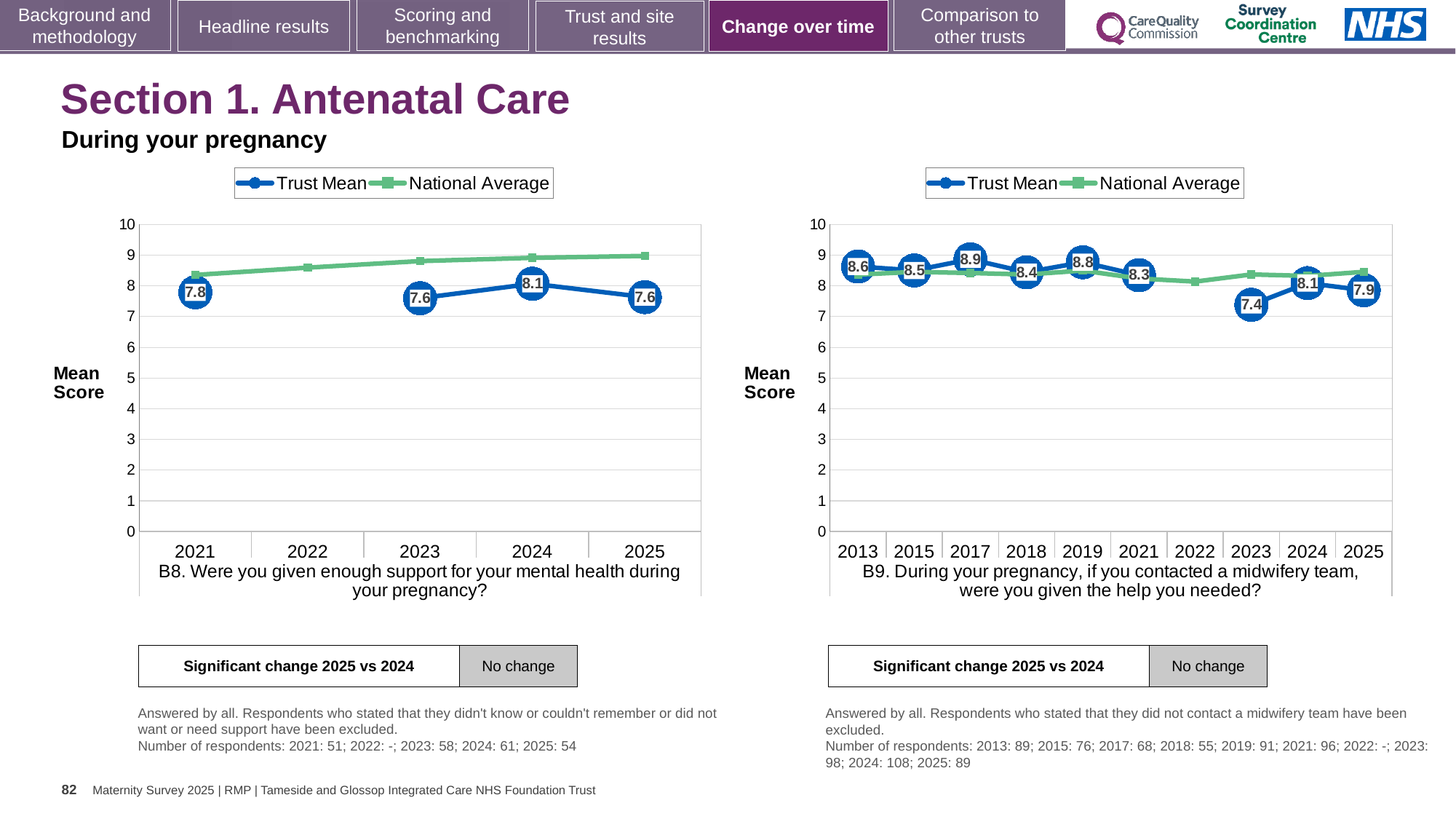
In the B9 chart on the right, which is larger, the Trust Mean for 2013 or the Trust Mean for 2018? 2013 In the B9 chart on the right, what is the Trust Mean for 2025? 7.9 In the B8 chart on the left, is the National Average for 2025 greater or less than 8? greater What kind of chart is the B8 chart on the left? Line chart In the B8 chart on the left, what is the Trust Mean for 2024? 8.1 How many years are shown on the x axis of the B9 chart on the right? 10 In the B8 chart on the left, what is the difference between the Trust Mean for 2024 and the Trust Mean for 2025? 0.5 In the B9 chart on the right, which year has the lowest Trust Mean? 2023 In the B9 chart on the right, what is the Trust Mean for 2023? 7.4 How many series does the legend of the B8 chart on the left list? 2 In the B9 chart on the right, which year has the highest Trust Mean? 2017 In the B8 chart on the left, what is the Trust Mean for 2021? 7.8